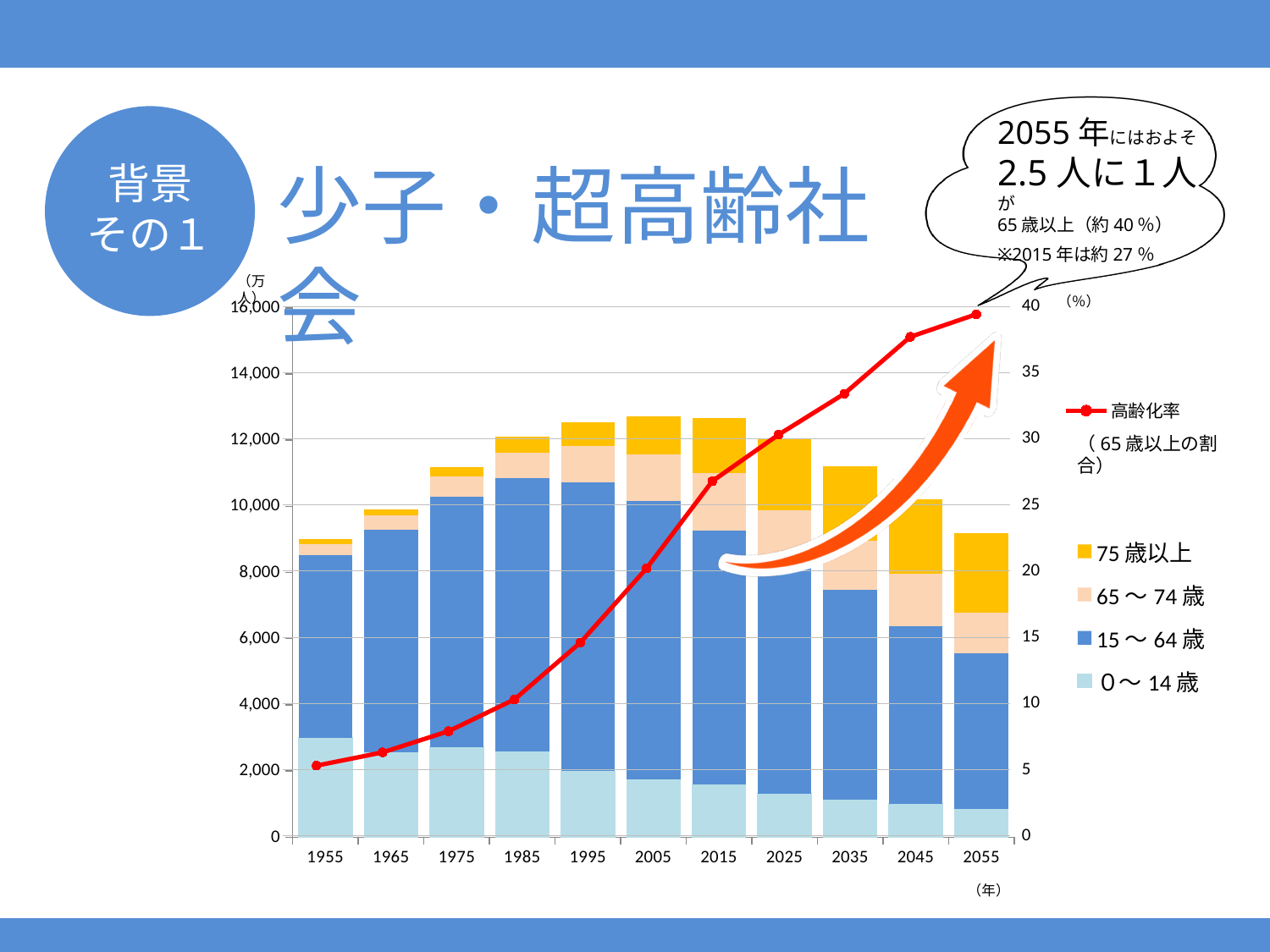
Is the total height of the stacked bar for 1975 greater or less than 10,000? greater How many years (categories) are shown along the x axis of the chart? 11 In which year is the 高齢化率 line at its highest? 2055 What kind of chart is shown on the slide? A stacked bar chart combined with a line chart Is the 高齢化率 value for 1955 greater or less than 10 on the right axis? less Is the 高齢化率 value for 2015 greater or less than 25 on the right axis? greater How many series does the chart's legend list? 5 Which legend entry is shown in yellow/orange? 75歳以上 Which is larger, the 高齢化率 value for 2025 or for 2045? 2045 In which year is the 高齢化率 line at its lowest? 1955 Does the 高齢化率 line rise or fall from 1955 to 2055? It rises